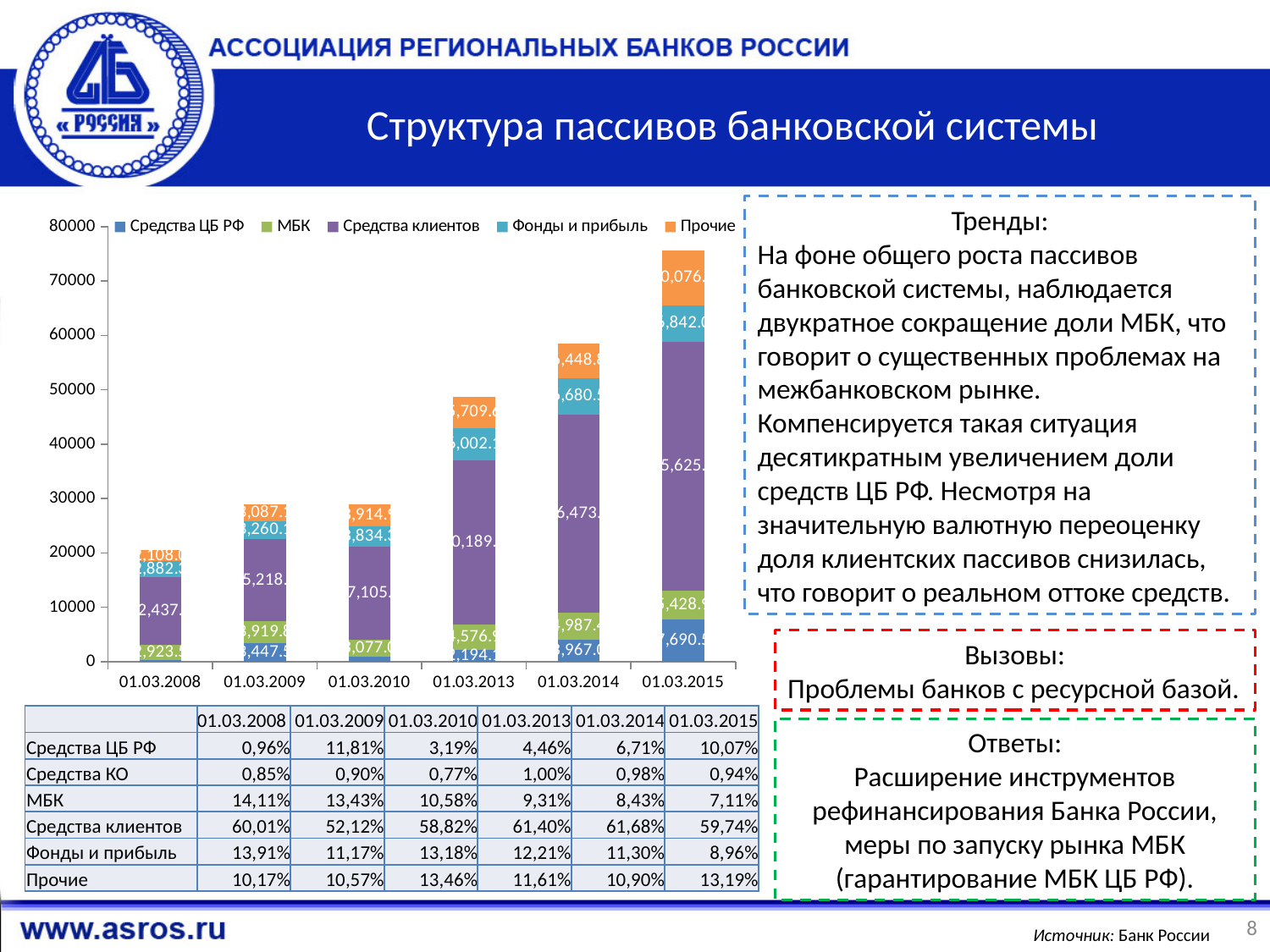
Which stacked bar is taller, 01.03.2013 or 01.03.2010? 01.03.2013 Which date has the tallest stacked bar in the chart? 01.03.2015 Is the total height of the stacked bar for 01.03.2013 greater or less than 40000? greater How many series does the chart legend list? 5 Do the total heights of the stacked bars generally rise or fall from 01.03.2008 to 01.03.2015? rise Is the total height of the stacked bar for 01.03.2015 greater or less than 70000? greater Is the total height of the stacked bar for 01.03.2008 greater or less than 30000? less What kind of chart is shown on the slide? Stacked bar chart What is the title of the chart on the slide? Структура пассивов банковской системы How many dates (categories) are shown on the x axis of the chart? 6 Which date has the shortest stacked bar in the chart? 01.03.2008